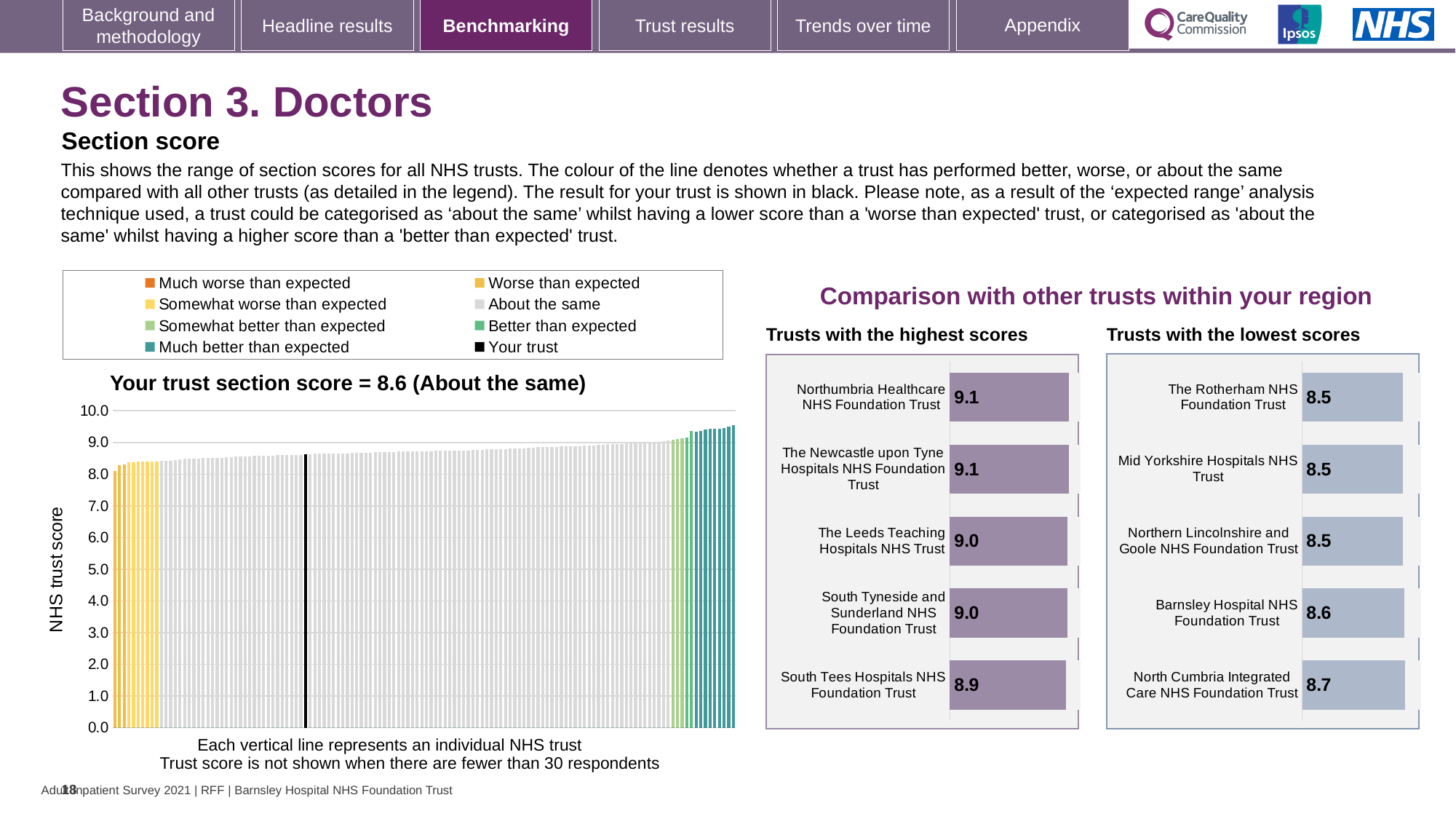
In the 'Trusts with the highest scores' chart, what is the score for South Tees Hospitals NHS Foundation Trust? 8.9 What type of chart is the main chart on the left showing the range of section scores? Bar chart What is the section score for your trust shown in the title of the main chart on the left? 8.6 In the 'Trusts with the lowest scores' chart, what is the score for Barnsley Hospital NHS Foundation Trust? 8.6 In the 'Trusts with the highest scores' chart, what is the difference between the score for Northumbria Healthcare NHS Foundation Trust and the score for South Tees Hospitals NHS Foundation Trust? 0.2 In the 'Trusts with the highest scores' chart, which trust has the lowest score? South Tees Hospitals NHS Foundation Trust In the 'Trusts with the highest scores' chart, what is the score for The Leeds Teaching Hospitals NHS Trust? 9.0 In the 'Trusts with the lowest scores' chart, which trust has the highest score? North Cumbria Integrated Care NHS Foundation Trust How many trusts are shown in the 'Trusts with the lowest scores' chart? 5 How many entries does the legend above the main chart on the left list? 8 In the 'Trusts with the lowest scores' chart, what is the score for North Cumbria Integrated Care NHS Foundation Trust? 8.7 In the 'Trusts with the lowest scores' chart, which is larger: the score for North Cumbria Integrated Care NHS Foundation Trust or the score for The Rotherham NHS Foundation Trust? North Cumbria Integrated Care NHS Foundation Trust